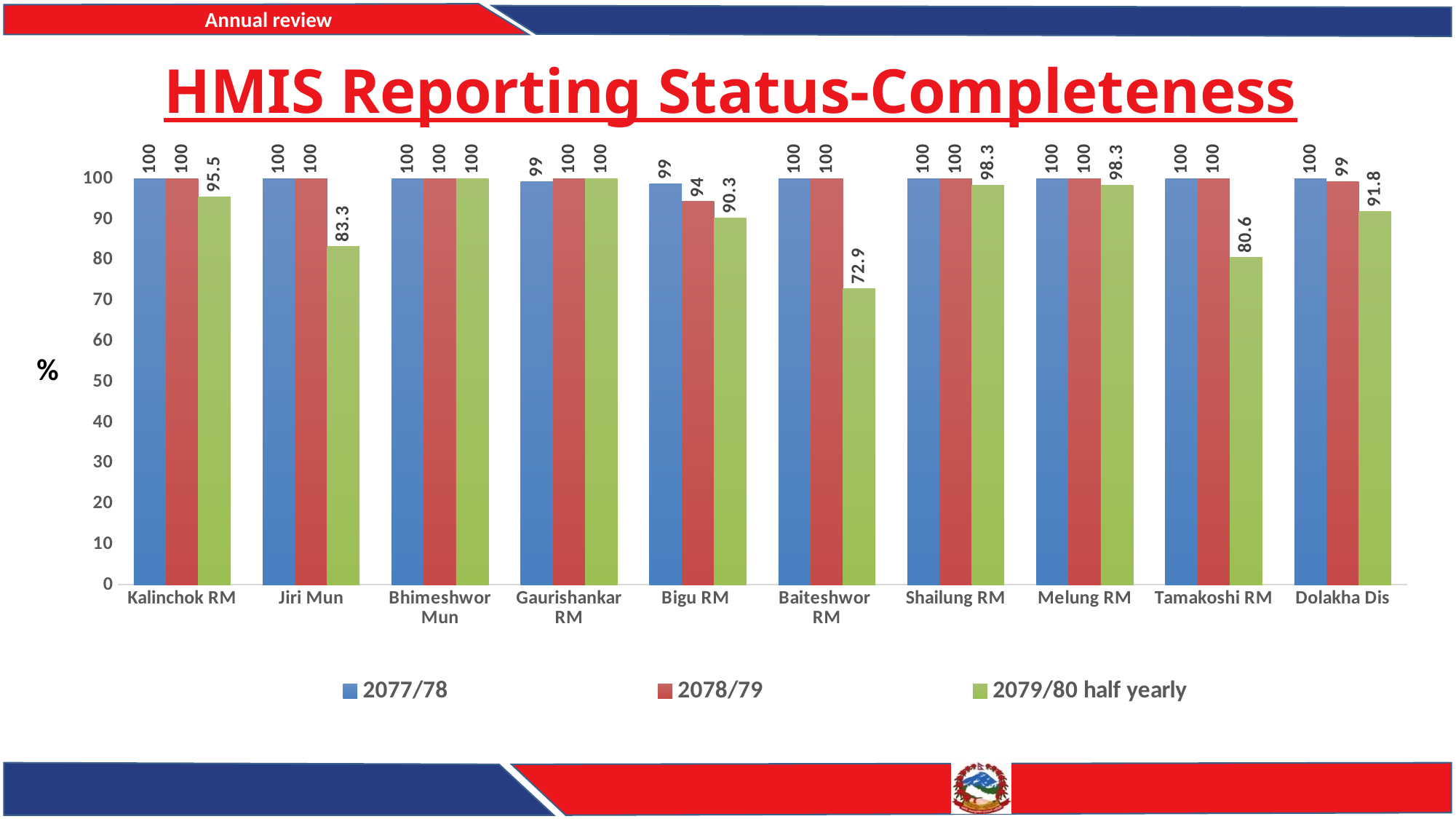
Which category has the lowest 2079/80 half yearly value? Baiteshwor RM Which colour represents the 2079/80 half yearly series? Green What is the 2078/79 value for Bigu RM? 94 How many categories are shown on the x axis? 10 What kind of chart is shown on the slide? Bar chart How many series does the legend list? 3 What is the 2077/78 value for Gaurishankar RM? 99 What is the difference between the 2078/79 and 2079/80 half yearly values for Tamakoshi RM? 19.4 Which is larger for Dolakha Dis: the 2078/79 value or the 2079/80 half yearly value? 2078/79 What is the 2079/80 half yearly value for Jiri Mun? 83.3 What is the 2079/80 half yearly value for Baiteshwor RM? 72.9 What is the title of the chart? HMIS Reporting Status-Completeness